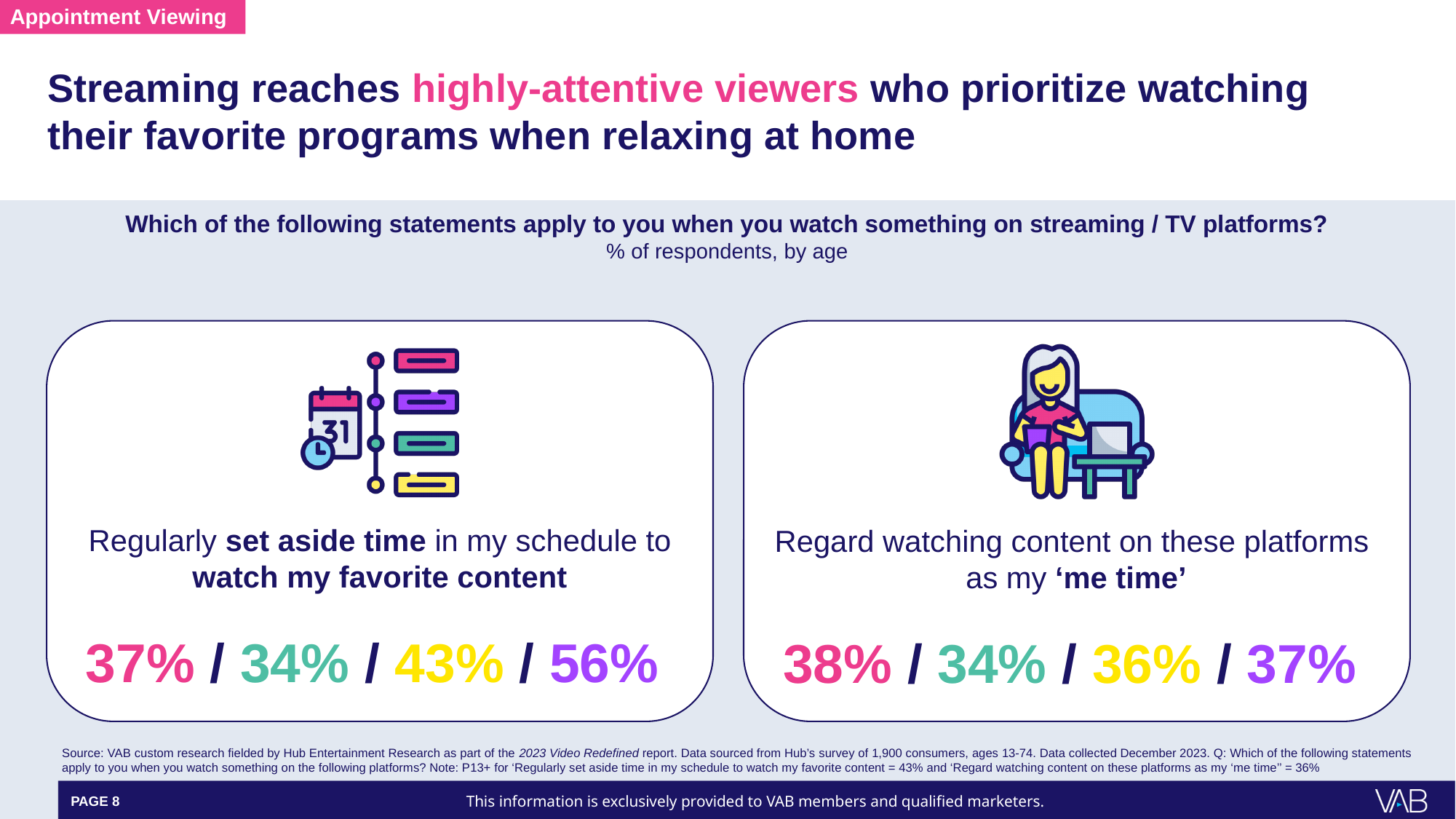
For the statement 'Regard watching content on these platforms as my ‘me time’', what is the highest percentage shown? 38% For the 'me time' statement, what is the last (purple) percentage shown? 37% For the 'set aside time' statement, what is the difference between the highest value (56%) and the lowest value (34%)? 22 percentage points According to the subtitle, how are the percentages broken down? % of respondents, by age For the 'set aside time' statement, what is the first (pink) percentage shown? 37% For the statement 'Regularly set aside time in my schedule to watch my favorite content', what is the highest percentage shown? 56% For the statement 'Regard watching content on these platforms as my ‘me time’', what is the lowest percentage shown? 34% How many percentage values are shown for each statement? 4 For the 'me time' statement, what is the third (yellow) percentage shown? 36% What is the survey question shown above the two boxes? Which of the following statements apply to you when you watch something on streaming / TV platforms? Which statement has the higher maximum percentage: 'set aside time' or 'me time'? Regularly set aside time in my schedule to watch my favorite content For the statement 'Regularly set aside time in my schedule to watch my favorite content', what is the lowest percentage shown? 34%